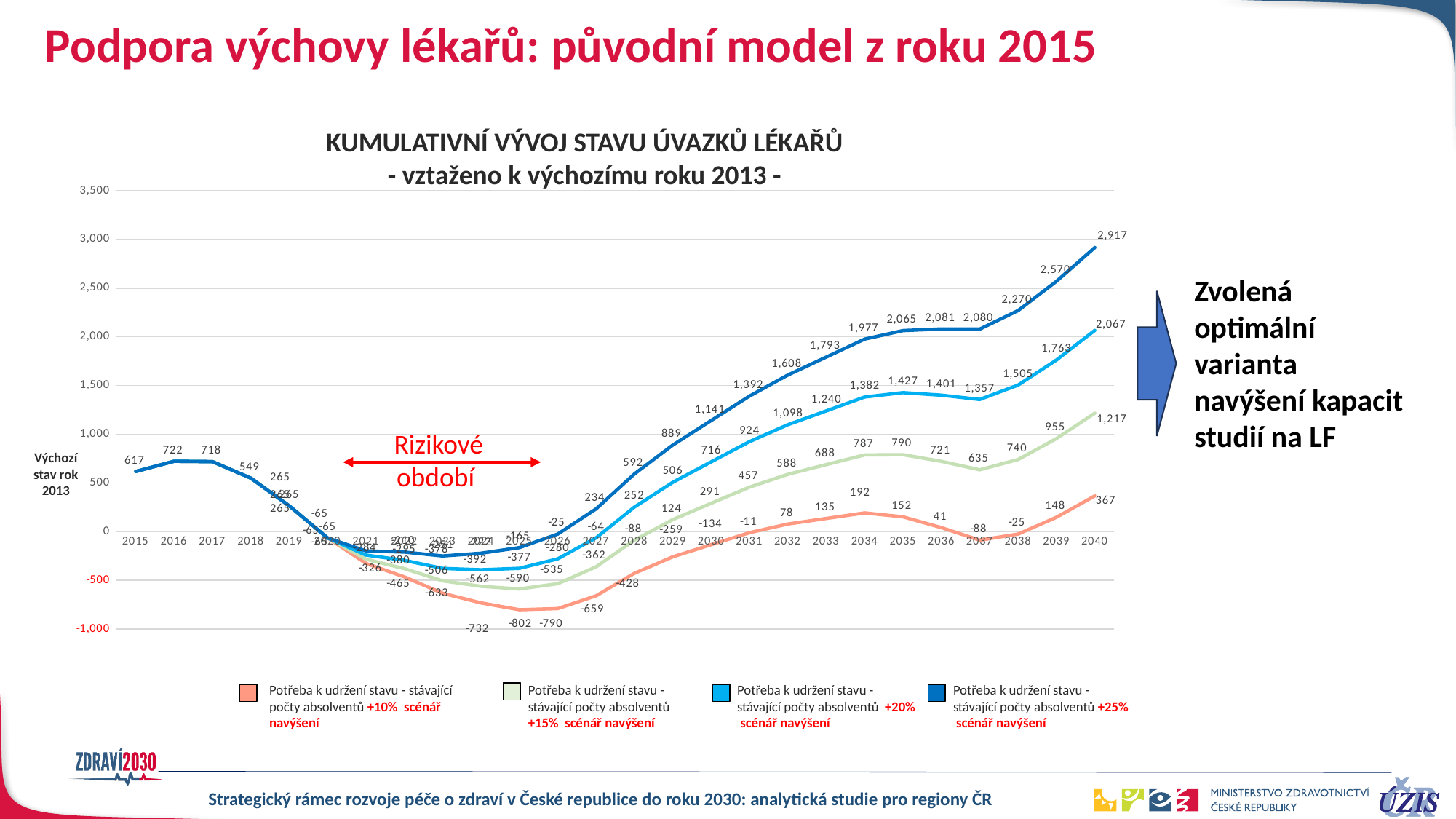
What is the value of the +20% scénář navýšení series in 2039? 1,763 Is the value of the +25% scénář navýšení series in 2033 greater or less than 1,500? greater What is the value of the +25% scénář navýšení series in 2040? 2,917 What kind of chart is shown on the slide? line chart How many series does the legend list? 4 What is the value shown for 2016? 722 In which year does the +10% scénář navýšení series reach its lowest value? 2025 What is the value of the +10% scénář navýšení series in 2040? 367 What is the title of the chart? KUMULATIVNÍ VÝVOJ STAVU ÚVAZKŮ LÉKAŘŮ - vztaženo k výchozímu roku 2013 - Which is larger for the +15% scénář navýšení series: the value in 2038 or in 2039? 2039 What is the difference between the +25% and +20% series values in 2040? 850 In which year does the +25% scénář navýšení series reach its highest value? 2040